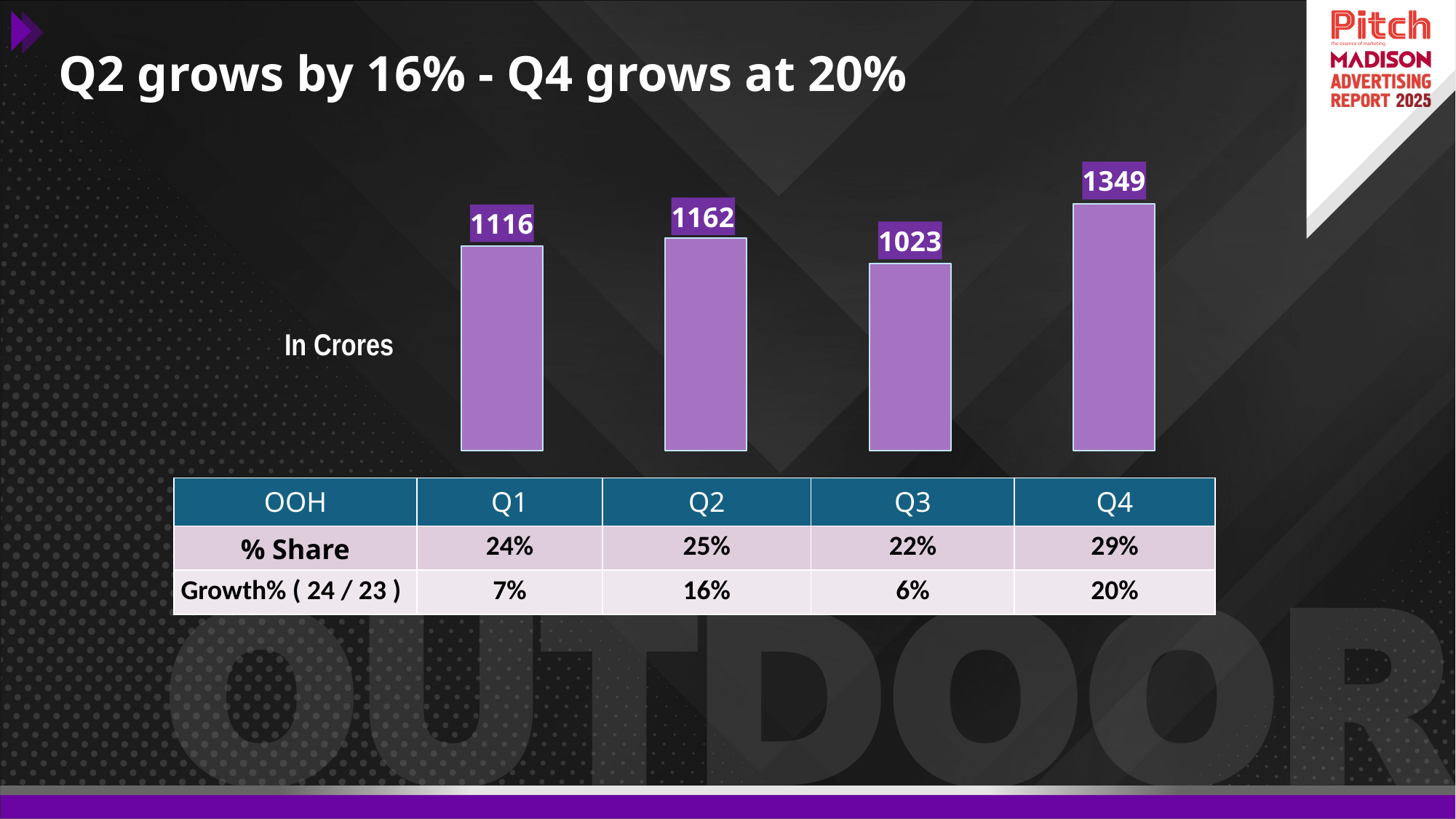
What type of chart is shown on the slide? Bar chart What unit label is shown next to the chart? In Crores What is the difference between the Q4 and Q3 bar values? 326 How many bars are plotted in the chart? 4 Which quarter has the highest bar? Q4 What is the value of the bar for Q3? 1023 Which quarter has the lowest bar? Q3 What is the difference between the Q2 and Q1 bar values? 46 What is the value of the bar for Q1? 1116 Which is larger, the bar for Q2 or the bar for Q3? Q2 What is the value of the bar for Q2? 1162 What is the value of the bar for Q4? 1349